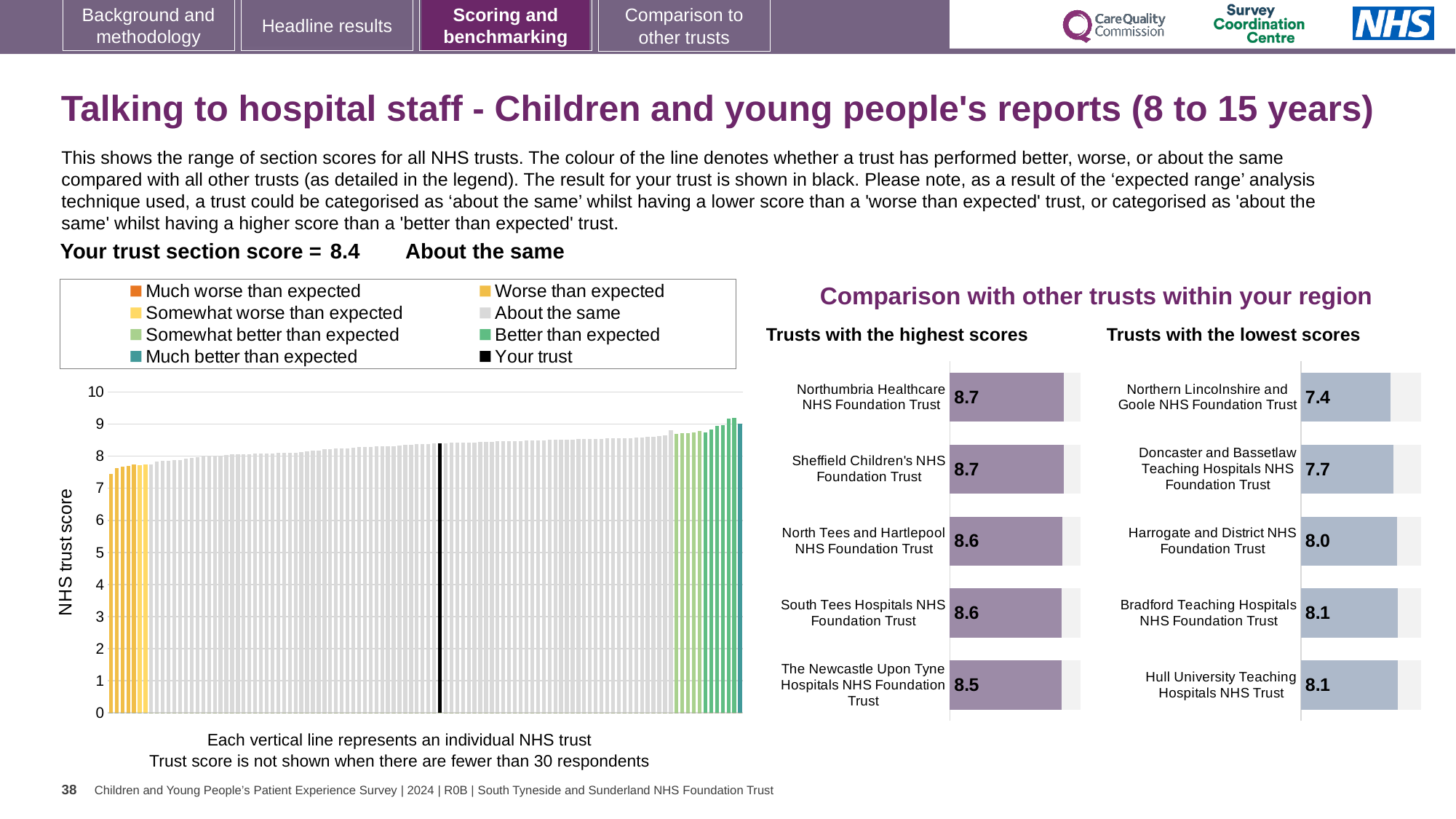
How many trusts are listed in the 'Trusts with the highest scores' chart? 5 In the 'Trusts with the lowest scores' chart, what is the difference between the scores of Harrogate and District NHS Foundation Trust and Northern Lincolnshire and Goole NHS Foundation Trust? 0.6 In the 'Trusts with the highest scores' chart, which trust has the lowest score? The Newcastle Upon Tyne Hospitals NHS Foundation Trust In the 'Trusts with the lowest scores' chart, which trust has the lowest score? Northern Lincolnshire and Goole NHS Foundation Trust What kind of chart is the main 'NHS trust score' chart on the left? bar chart In the 'Trusts with the highest scores' chart, what is the score for North Tees and Hartlepool NHS Foundation Trust? 8.6 In the 'Trusts with the lowest scores' chart, which has the higher score: Doncaster and Bassetlaw Teaching Hospitals NHS Foundation Trust or Harrogate and District NHS Foundation Trust? Harrogate and District NHS Foundation Trust In the main 'NHS trust score' chart on the left, is the value for the black 'Your trust' bar greater or less than 8? greater In the 'Trusts with the lowest scores' chart, what is the score for Harrogate and District NHS Foundation Trust? 8.0 In the 'Trusts with the highest scores' chart, what is the score for The Newcastle Upon Tyne Hospitals NHS Foundation Trust? 8.5 How many entries does the legend of the main chart on the left list? 8 In the main 'NHS trust score' chart on the left, do the bar values rise or fall from left to right? rise